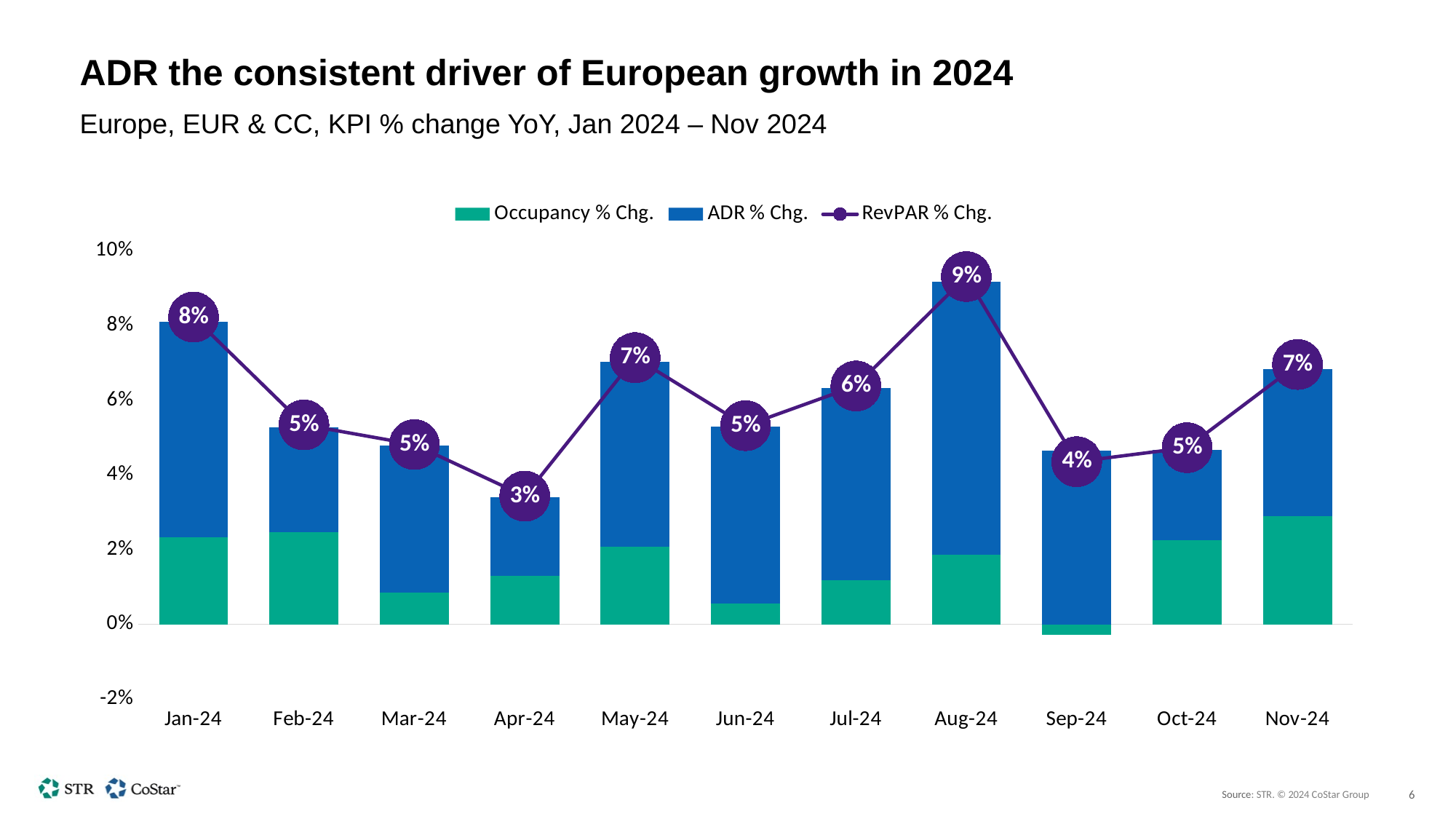
How many months are shown on the x axis? 11 Does the RevPAR % Chg. rise or fall from Aug-24 to Sep-24? Fall What is the RevPAR % Chg. value for Aug-24? 9% Which month has the highest RevPAR % Chg.? Aug-24 Which month has a higher RevPAR % Chg., Jan-24 or May-24? Jan-24 Is the Occupancy % Chg. value for Sep-24 greater or less than 0%? less What is the RevPAR % Chg. value for Apr-24? 3% What kind of chart is shown on the slide? A stacked bar chart combined with a line chart Which month has the lowest RevPAR % Chg.? Apr-24 How many series does the legend list? 3 What is the RevPAR % Chg. value for Jan-24? 8% What is the difference between the RevPAR % Chg. for Aug-24 and Apr-24? 6 percentage points